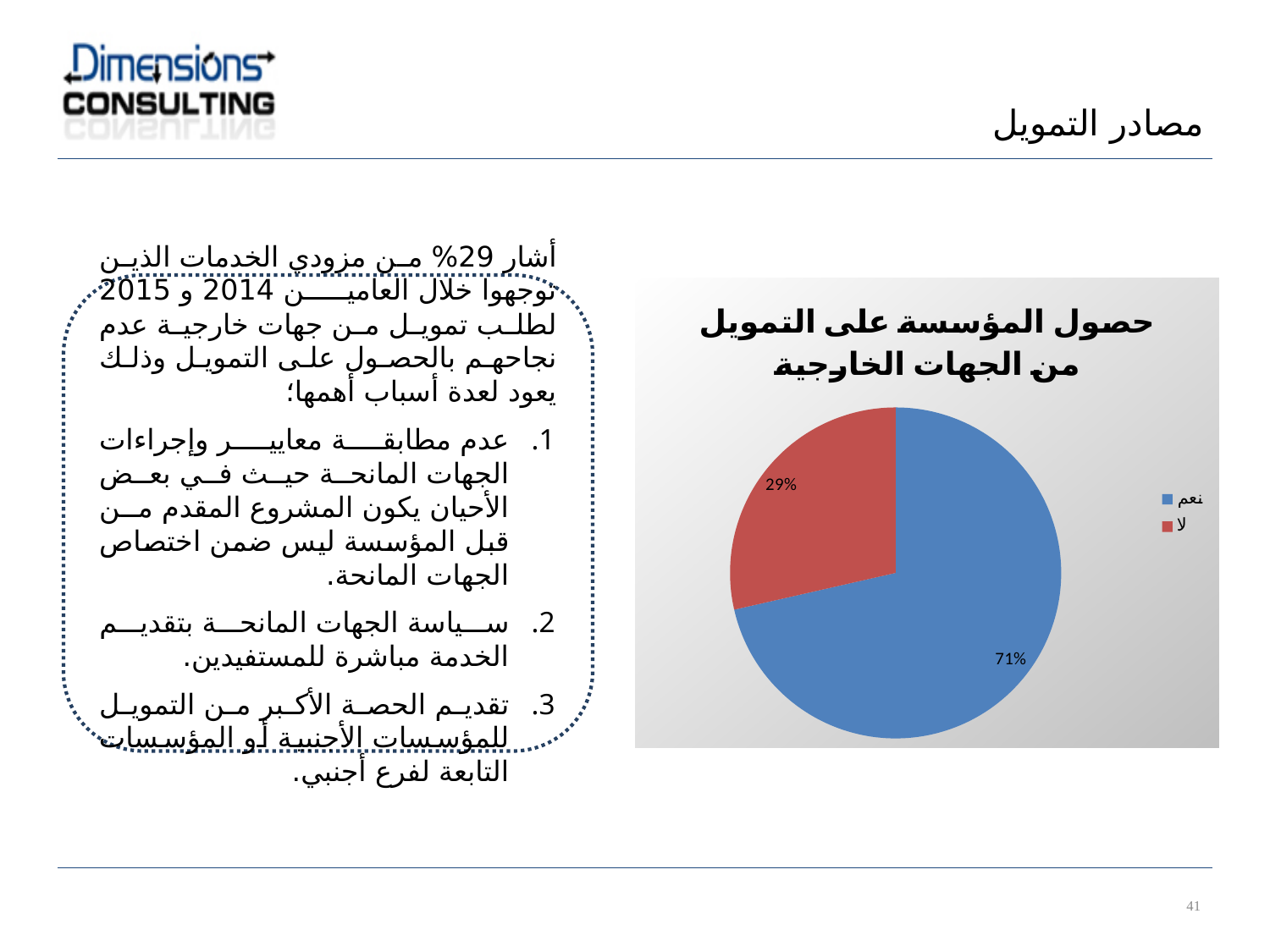
What type of chart is shown on the slide? pie chart What share of the pie does the "لا" slice represent? 29% Which slice is larger, "نعم" or "لا"? نعم What percentage is shown for the "لا" slice? 29% What colour is the "لا" slice? red What percentage is shown for the "نعم" slice? 71% How many slices does the pie chart have? 2 How many entries does the legend list? 2 Which category has the smallest share of the pie? لا What is the difference in percentage points between the "نعم" and "لا" slices? 42 Which category has the largest share of the pie? نعم What is the title of the chart? حصول المؤسسة على التمويل من الجهات الخارجية